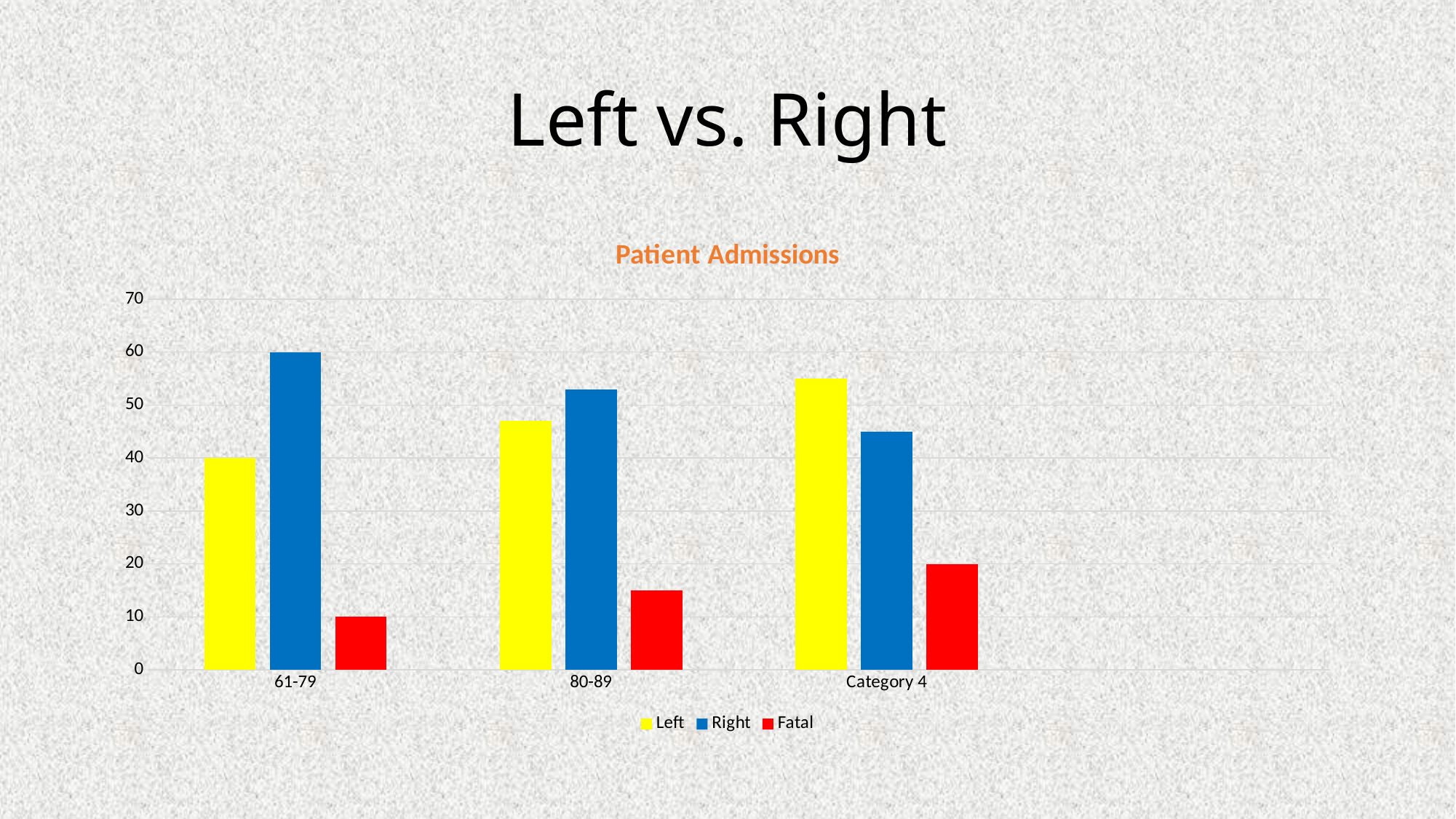
What kind of chart is shown on the slide? bar chart How many categories are shown on the x axis? 3 What is the value for Right in the 61-79 category? 60 In Category 4, which is larger, Left or Right? Left What is the title of the chart? Patient Admissions Which category has the highest Right value? 61-79 What is the value for Left in the 61-79 category? 40 How many series does the legend list? 3 What is the value for Fatal in Category 4? 20 What is the value for Fatal in the 61-79 category? 10 Is the value for Left in Category 4 greater or less than 50? greater What is the difference between the Right and Left values in the 61-79 category? 20